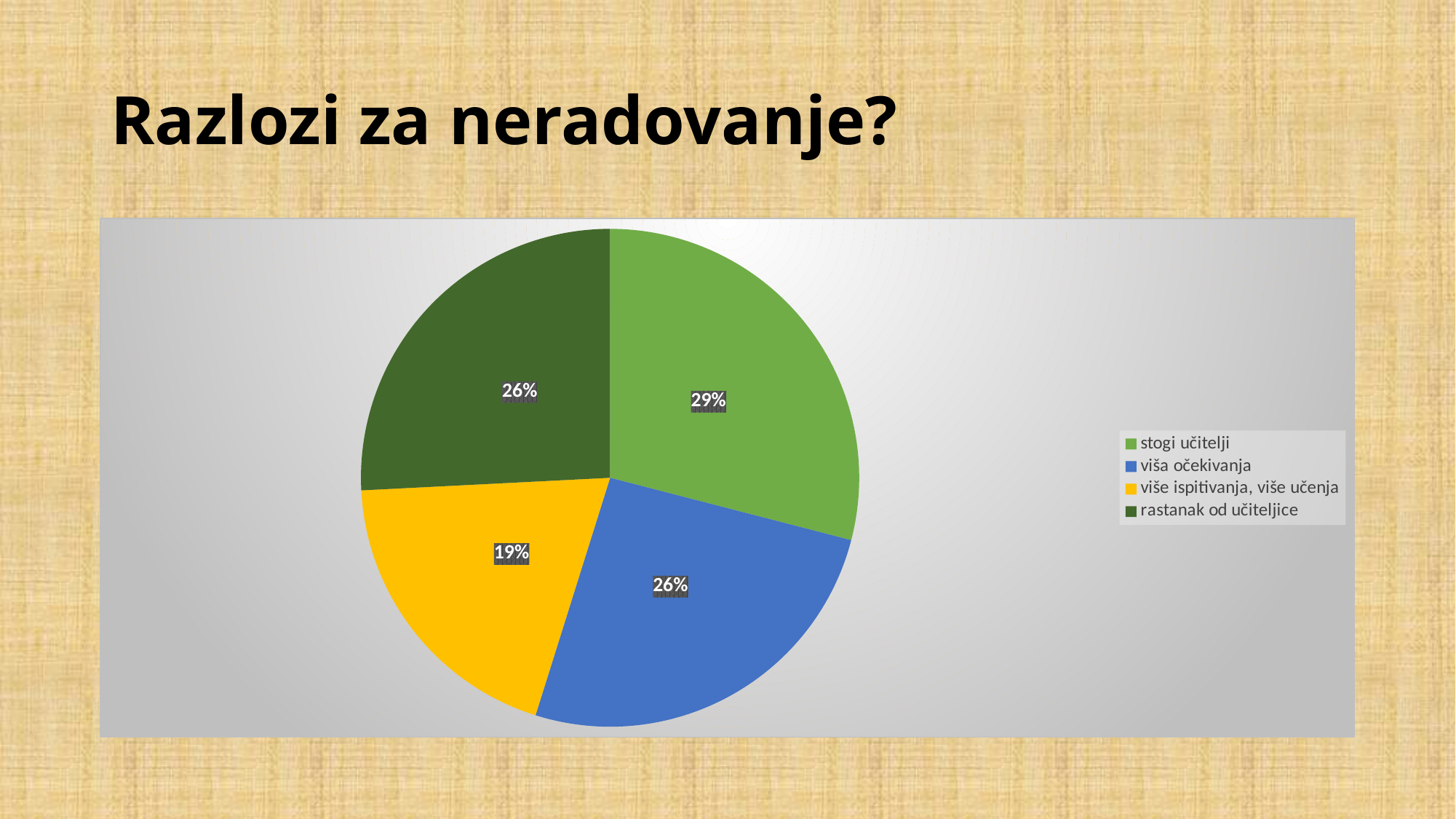
How many slices does the pie chart have? 4 What percentage is shown for the slice "stogi učitelji"? 29% What kind of chart is shown on the slide? pie chart What percentage is shown for the slice "viša očekivanja"? 26% What is the difference in percentage points between "stogi učitelji" and "više ispitivanja, više učenja"? 10 percentage points Which category has the largest slice of the pie? stogi učitelji Which is larger, the slice for "stogi učitelji" or the slice for "viša očekivanja"? stogi učitelji Which colour represents "više ispitivanja, više učenja" in the legend? yellow What percentage is shown for the slice "više ispitivanja, više učenja"? 19% What share of the pie does "rastanak od učiteljice" take? 26% Which category has the smallest slice of the pie? više ispitivanja, više učenja What is the title of the slide? Razlozi za neradovanje?